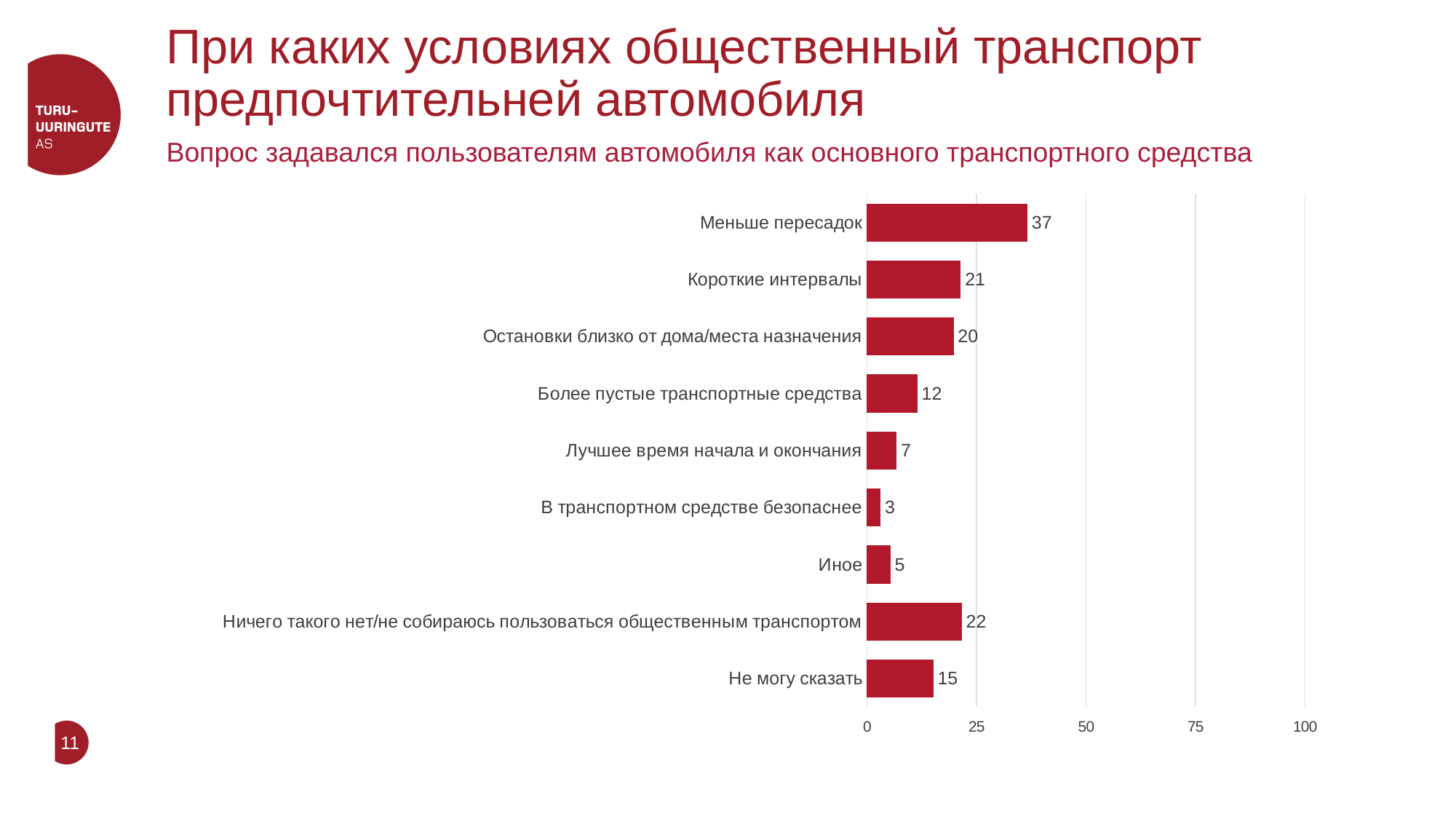
Which category has the lowest value? В транспортном средстве безопаснее What kind of chart is shown on the slide? bar chart What is the highest tick value shown on the horizontal axis? 100 What is the value for "Не могу сказать"? 15 Which is larger: the value for "Более пустые транспортные средства" or the value for "Не могу сказать"? Не могу сказать Is the value for "Меньше пересадок" greater or less than 25? greater What is the value for "Меньше пересадок"? 37 What is the difference between the values for "Меньше пересадок" and "Короткие интервалы"? 16 What is the value for "Остановки близко от дома/места назначения"? 20 How many categories are shown in the chart? 9 What is the value for "Иное"? 5 Which category has the highest value? Меньше пересадок